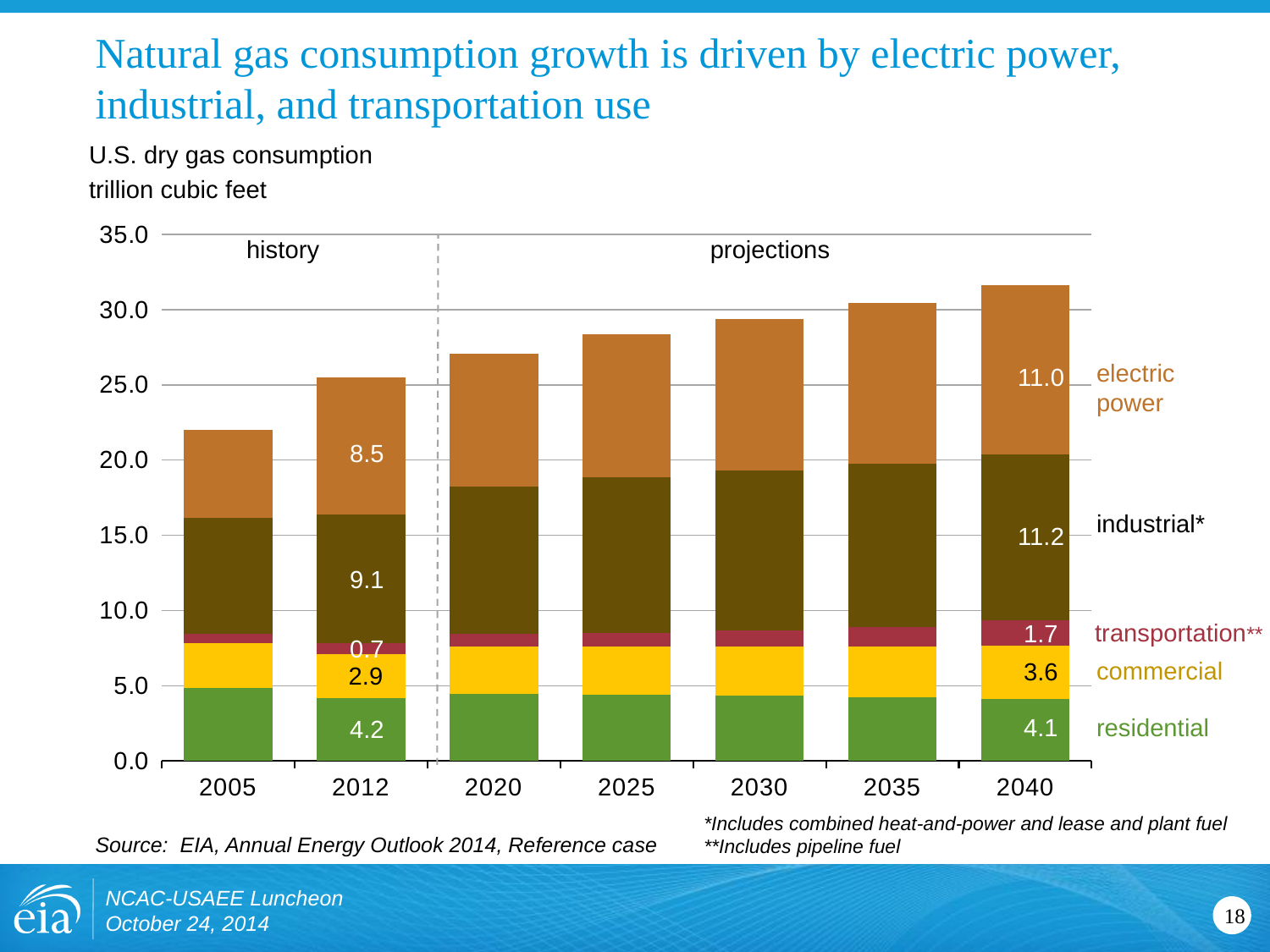
What kind of chart is shown on the slide? Stacked bar chart What is the total dry gas consumption for the 2040 bar, summing its labeled segments? 31.6 By how much does electric power consumption in 2040 exceed that in 2012? 2.5 What is the electric power consumption value shown for 2040? 11.0 How many years are shown on the x axis? 7 In 2040, which is larger: industrial or electric power consumption? Industrial What is the industrial consumption value shown for 2012? 9.1 How many sectors (series) are stacked in each bar? 5 What is the transportation value shown for 2040? 1.7 What is the total dry gas consumption for the 2012 bar, summing its labeled segments? 25.4 Does total natural gas consumption rise or fall from 2005 to 2040? Rise Is the total consumption for 2005 greater or less than 20.0? greater